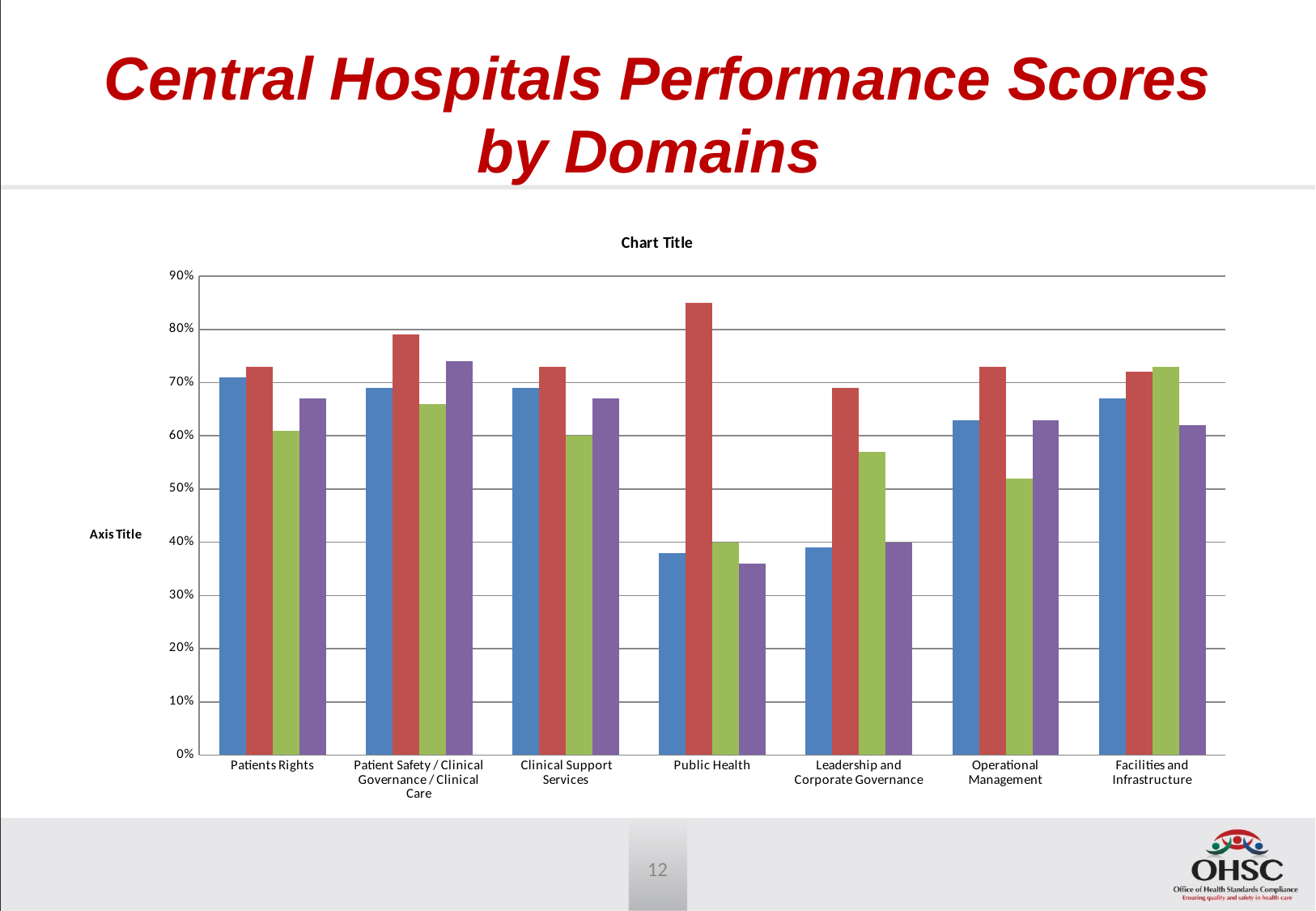
In which domain is the red bar the tallest? Public Health What is the title printed above the chart? Chart Title In which domain is the green bar the tallest? Facilities and Infrastructure How many domain categories are shown along the x axis? 7 Is the blue bar for Public Health greater or less than 50%? less Is the purple bar for Public Health greater or less than 40%? less Is the red bar for Patient Safety / Clinical Governance / Clinical Care greater or less than 70%? greater For Public Health, which is larger, the red bar or the blue bar? the red bar How many bars are plotted for each domain category? 4 What kind of chart is shown on the slide? bar chart